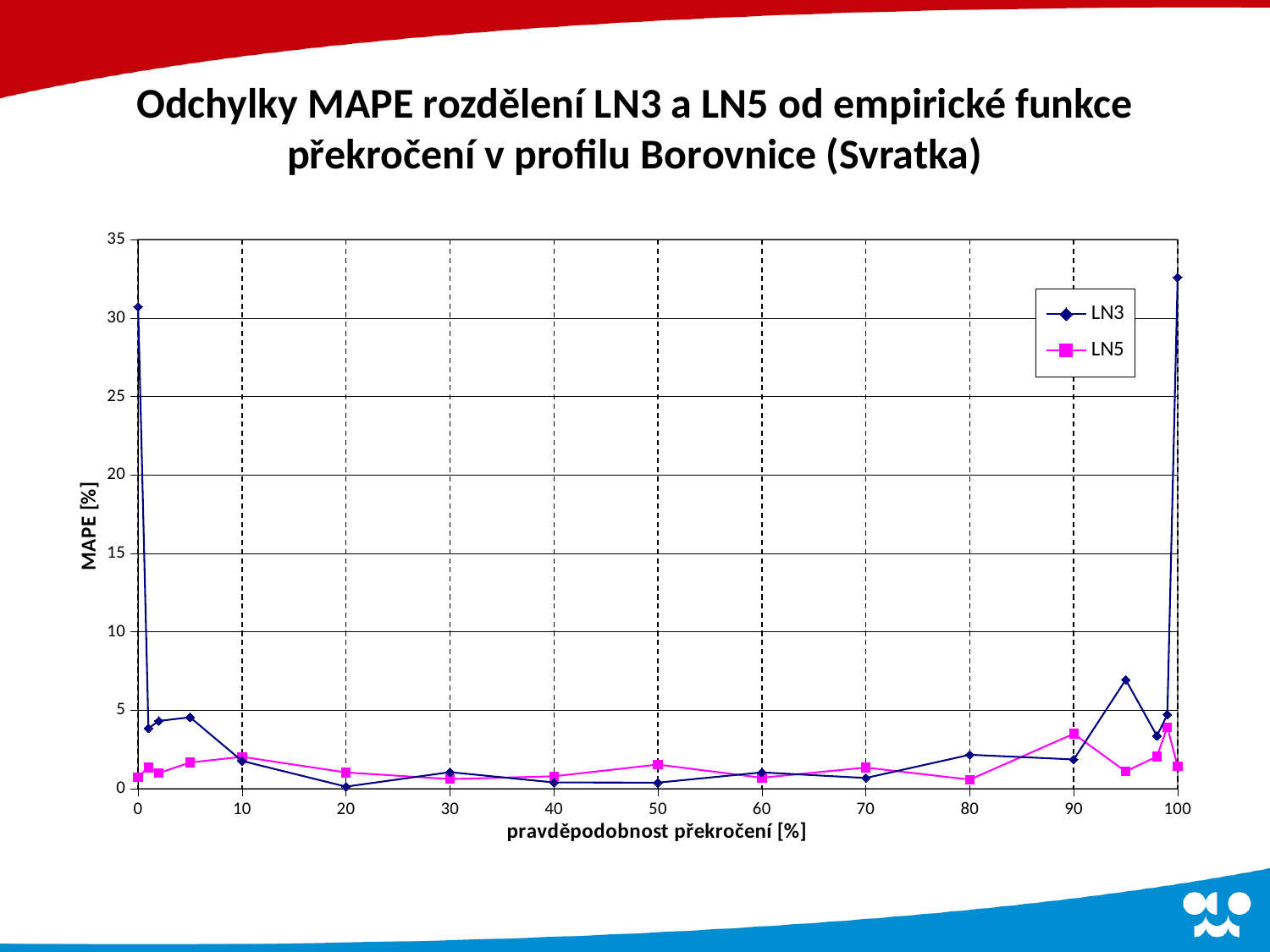
What is the label of the x axis? pravděpodobnost překročení [%] What kind of chart is shown on the slide? line chart Is the LN3 value at a probability of 0% greater or less than 25? greater How many series does the legend list? 2 Is the LN3 value at a probability of 100% greater or less than 30? greater Which series reaches the highest MAPE value on the chart? LN3 What are the names of the two series in the legend? LN3 and LN5 At a probability of 95%, which series has the higher MAPE, LN3 or LN5? LN3 Does the LN3 series rise or fall between a probability of 98% and 100%? rise At a probability of 90%, which series has the higher MAPE, LN3 or LN5? LN5 Is the LN3 value at a probability of 95% greater or less than 5? greater